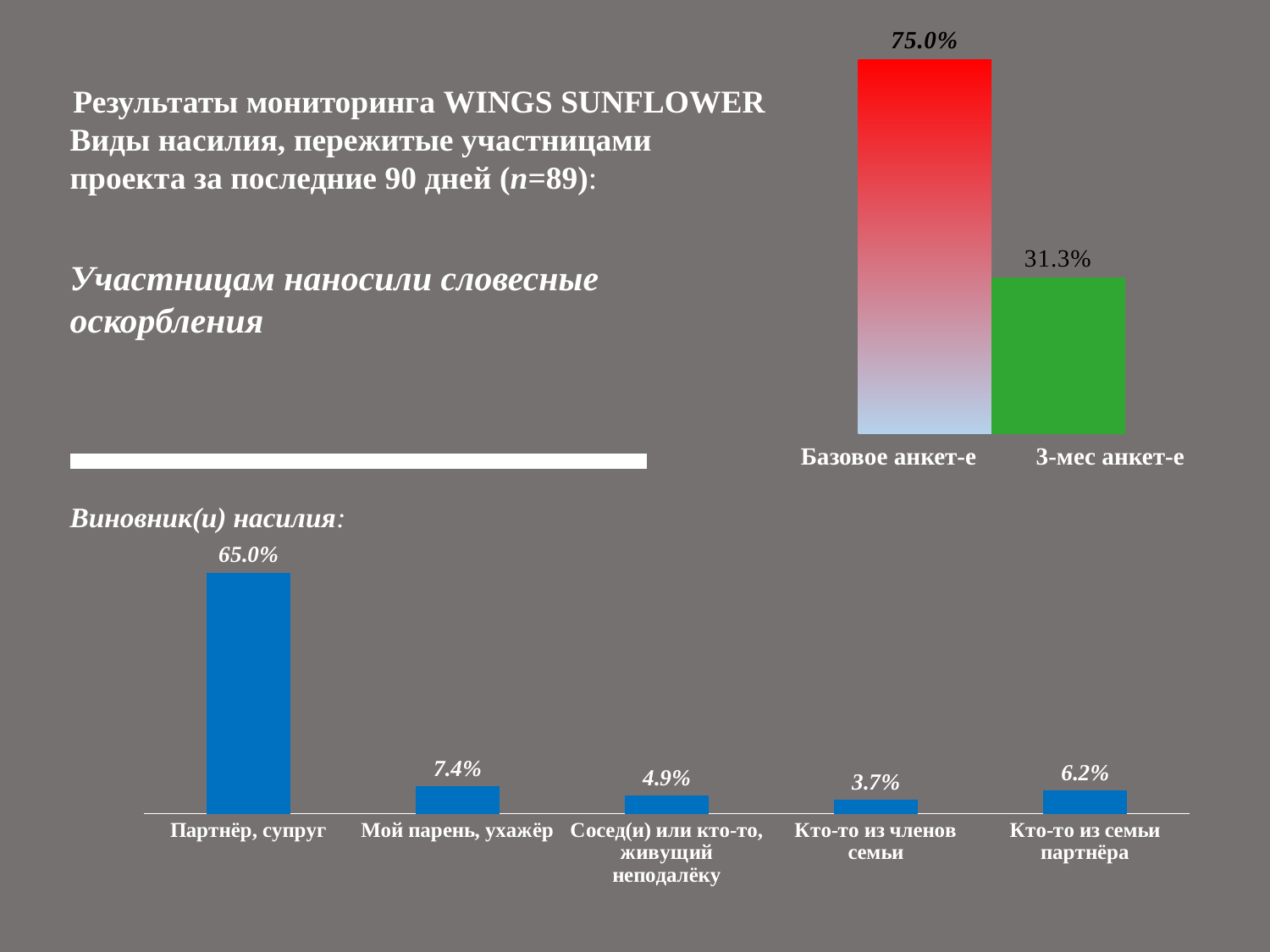
In the bottom chart (Виновник(и) насилия), how many categories are shown? 5 In the top-right chart, what is the difference between the Базовое анкет-е and 3-мес анкет-е values? 43.7% In the top-right chart, what is the value for Базовое анкет-е? 75.0% In the bottom chart (Виновник(и) насилия), which category has the highest value? Партнёр, супруг In the bottom chart (Виновник(и) насилия), which category has the lowest value? Кто-то из членов семьи In the top-right chart, what is the value for 3-мес анкет-е? 31.3% In the bottom chart (Виновник(и) насилия), what is the value for Партнёр, супруг? 65.0% In the bottom chart (Виновник(и) насилия), what is the value for Кто-то из семьи партнёра? 6.2% In the top-right chart, do the values rise or fall from Базовое анкет-е to 3-мес анкет-е? fall In the top-right chart, how many bars are plotted? 2 In the bottom chart (Виновник(и) насилия), which is larger: Мой парень, ухажёр or Сосед(и) или кто-то, живущий неподалёку? Мой парень, ухажёр In the bottom chart (Виновник(и) насилия), what is the difference between Мой парень, ухажёр and Кто-то из членов семьи? 3.7%